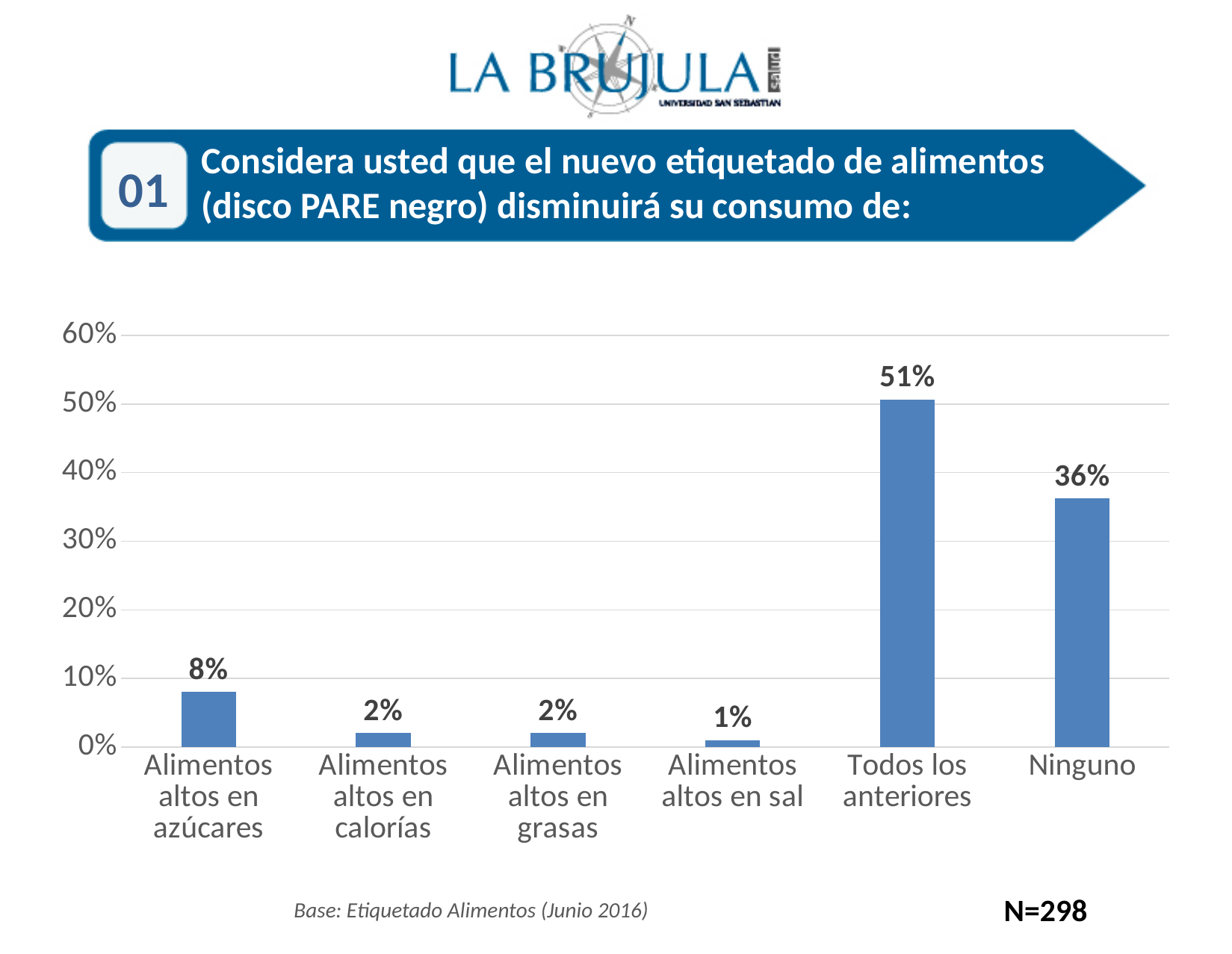
Which category has the lowest value? Alimentos altos en sal What is the difference between the values for "Todos los anteriores" and "Ninguno"? 15% What is the value for "Alimentos altos en sal"? 1% What kind of chart is shown on the slide? bar chart What is the value for "Alimentos altos en azúcares"? 8% Is the value for "Ninguno" greater or less than 40%? less What is the value for "Ninguno"? 36% Which is larger, the value for "Alimentos altos en azúcares" or the value for "Alimentos altos en calorías"? Alimentos altos en azúcares What is the value for "Todos los anteriores"? 51% What is the sample size (N) stated on the slide? N=298 Which category has the highest value? Todos los anteriores How many categories are shown on the x axis? 6